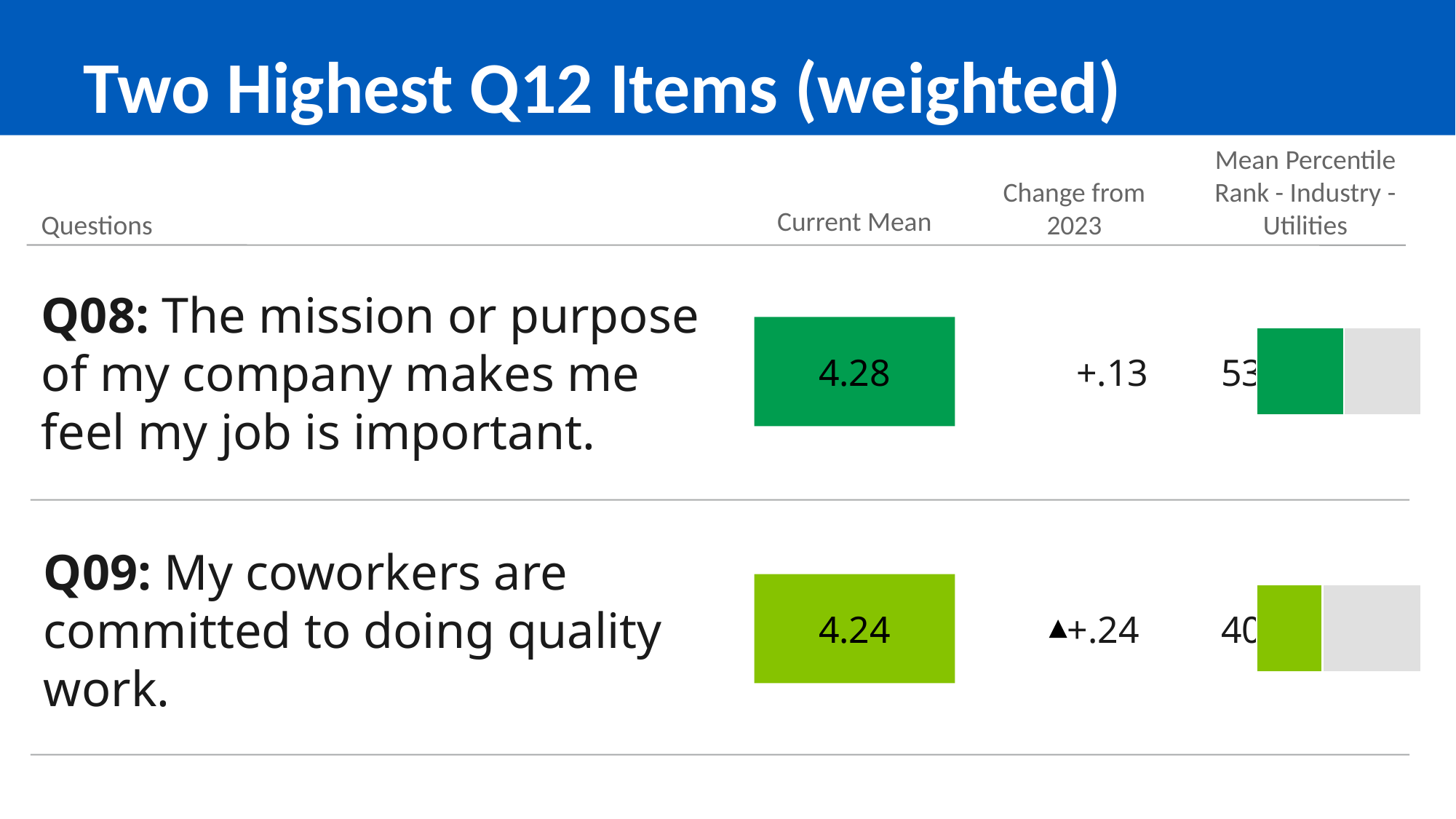
What is the Current Mean for Q08 (The mission or purpose of my company makes me feel my job is important)? 4.28 What is the difference between the Current Mean of Q08 and the Current Mean of Q09? 0.04 What is the Current Mean for Q09 (My coworkers are committed to doing quality work)? 4.24 How many Q12 items are shown on the slide? 2 What is the Change from 2023 for Q09? +.24 Which item has the lower Mean Percentile Rank - Industry - Utilities? Q09 What is the Mean Percentile Rank - Industry - Utilities for Q08? 53 Which item shows the larger Change from 2023, Q08 or Q09? Q09 What is the Change from 2023 for Q08? +.13 What is the title of the slide? Two Highest Q12 Items (weighted) Which item has the higher Current Mean, Q08 or Q09? Q08 What is the Mean Percentile Rank - Industry - Utilities for Q09? 40